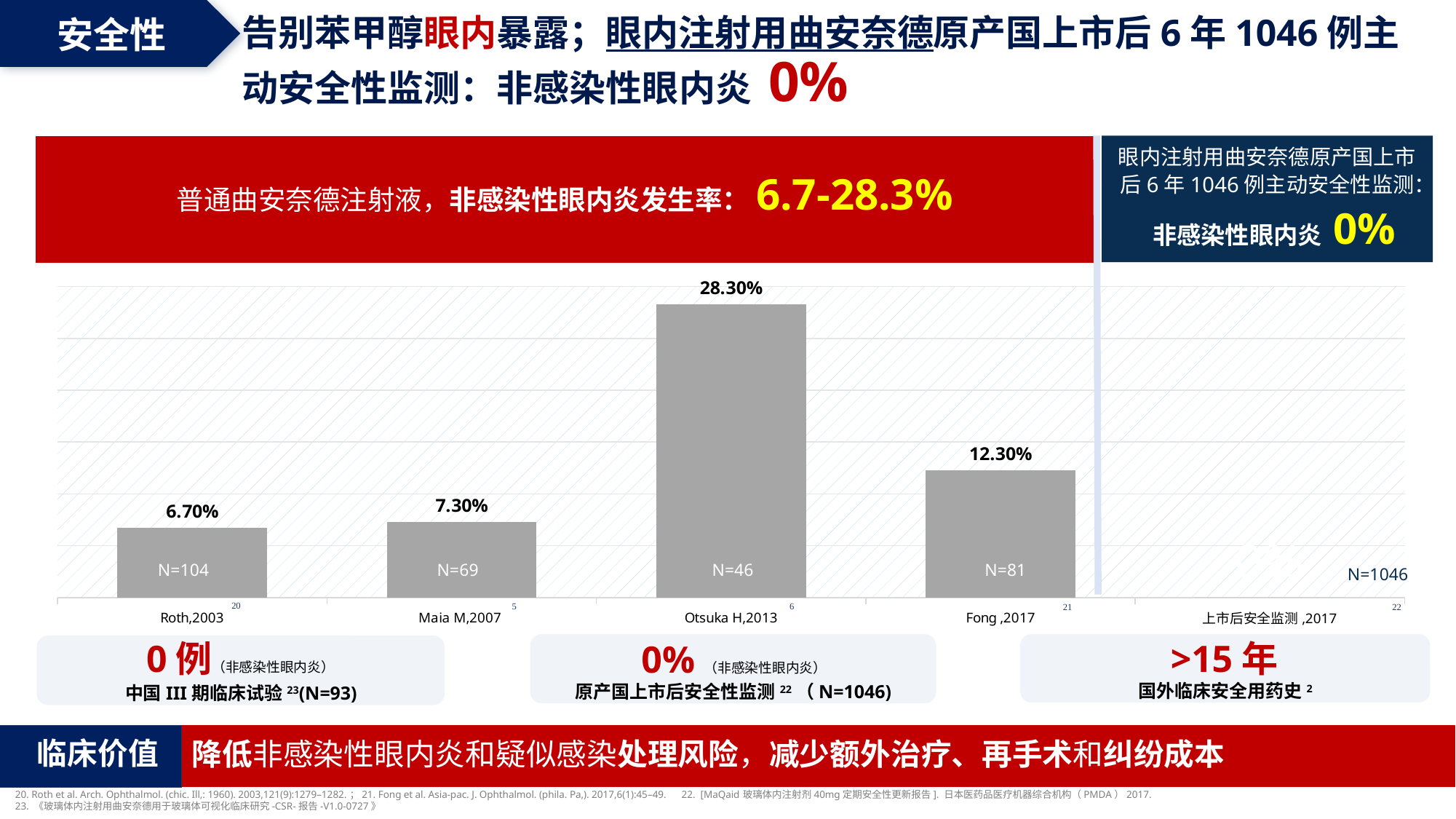
What type of chart is shown on the slide? Bar chart What is the difference between the values for Otsuka H,2013 and Roth,2003? 21.60% What sample size (N) is printed on the bar for Otsuka H,2013? N=46 What is the value shown for Fong ,2017? 12.30% What sample size (N) is printed for 上市后安全监测 ,2017? N=1046 How many categories are shown on the x axis of the chart? 5 Which is larger, the value for Fong ,2017 or the value for Maia M,2007? Fong ,2017 What is the value shown for Maia M,2007? 7.30% Among the four categories with labeled bars, which has the lowest value? Roth,2003 What is the value shown for Otsuka H,2013? 28.30% What is the value shown for Roth,2003? 6.70% Which category has the highest bar? Otsuka H,2013